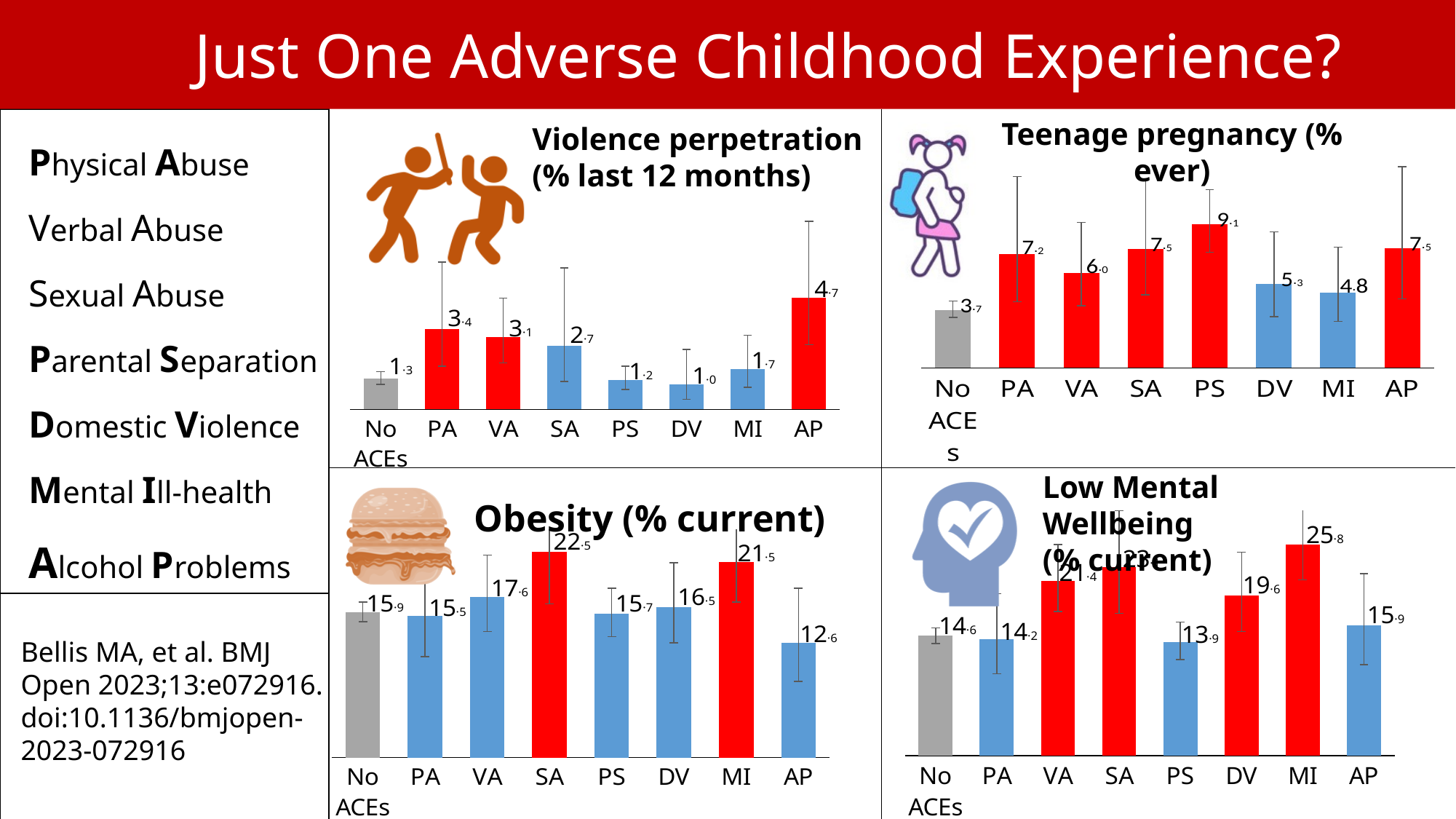
In the Obesity (% current) chart, which category has the lowest value? AP In the Obesity (% current) chart, which category has the highest value? SA In the Violence perpetration (% last 12 months) chart, which category has the lowest value? DV In the Low Mental Wellbeing (% current) chart, what is the value for MI? 25.8 In the Teenage pregnancy (% ever) chart, which is larger, the value for PA or the value for VA? PA In the Obesity (% current) chart, what is the difference between the SA value and the No ACEs value? 6.6 In the Violence perpetration (% last 12 months) chart, which category has the highest value? AP In the Violence perpetration (% last 12 months) chart, what is the value for AP? 4.7 In the Low Mental Wellbeing (% current) chart, which is larger, the value for DV or the value for PS? DV In the Teenage pregnancy (% ever) chart, what is the value for PS? 9.1 How many categories are shown on the x axis of the Obesity (% current) chart? 8 In the Teenage pregnancy (% ever) chart, what is the difference between the PS value and the No ACEs value? 5.4